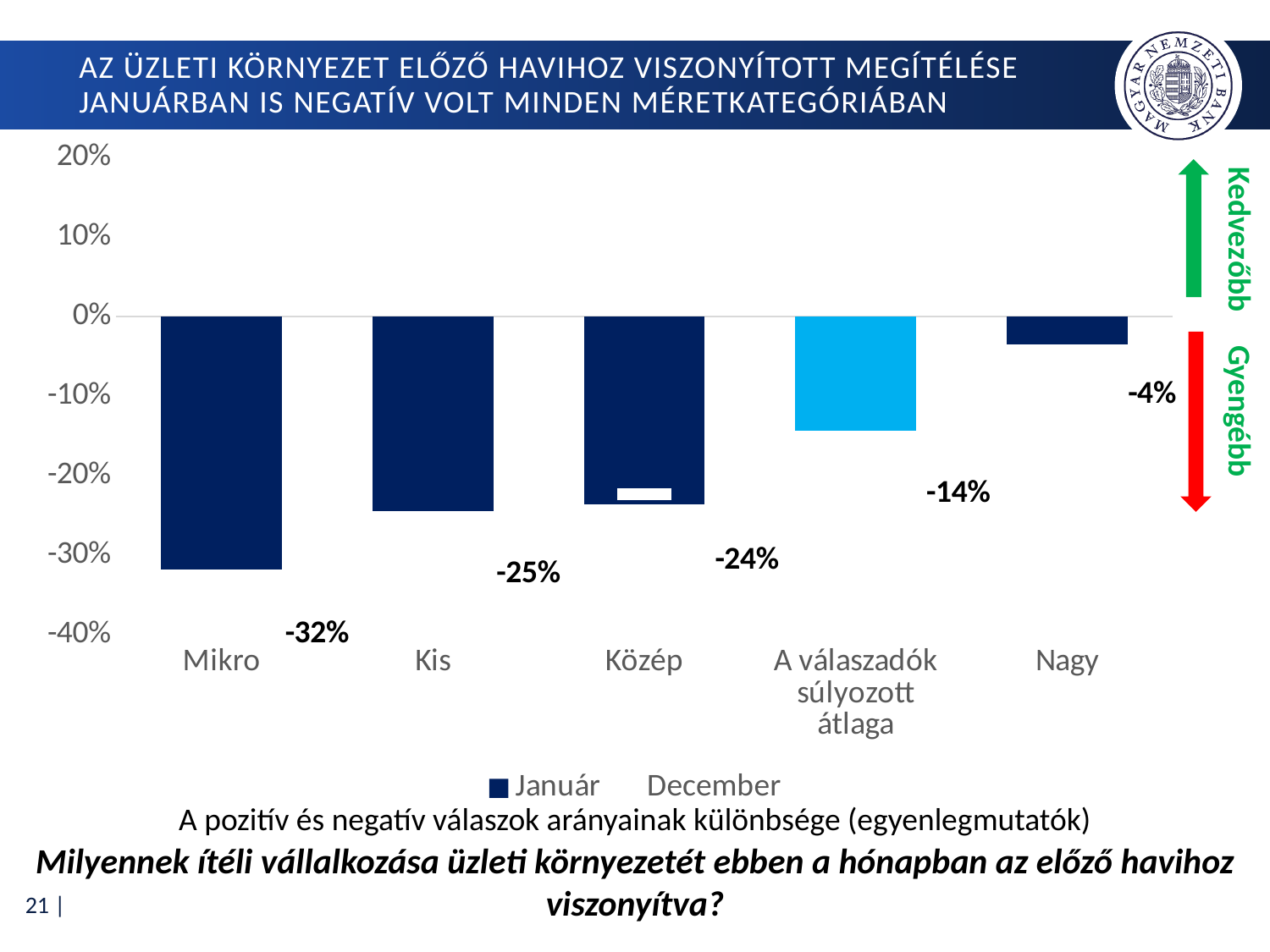
How many categories are shown on the x axis? 5 Which category has the highest value? Nagy What is the difference between the values for Mikro and Nagy? 28 percentage points Which category has the lowest value? Mikro What is the value for A válaszadók súlyozott átlaga? -14% What is the value for Nagy? -4% What is the value for Kis? -25% Which is larger, the value for Közép or the value for Mikro? Közép What is the value for Mikro? -32% Is the value for Kis greater or less than -20%? less How many series does the legend list? 2 What kind of chart is shown on the slide? bar chart